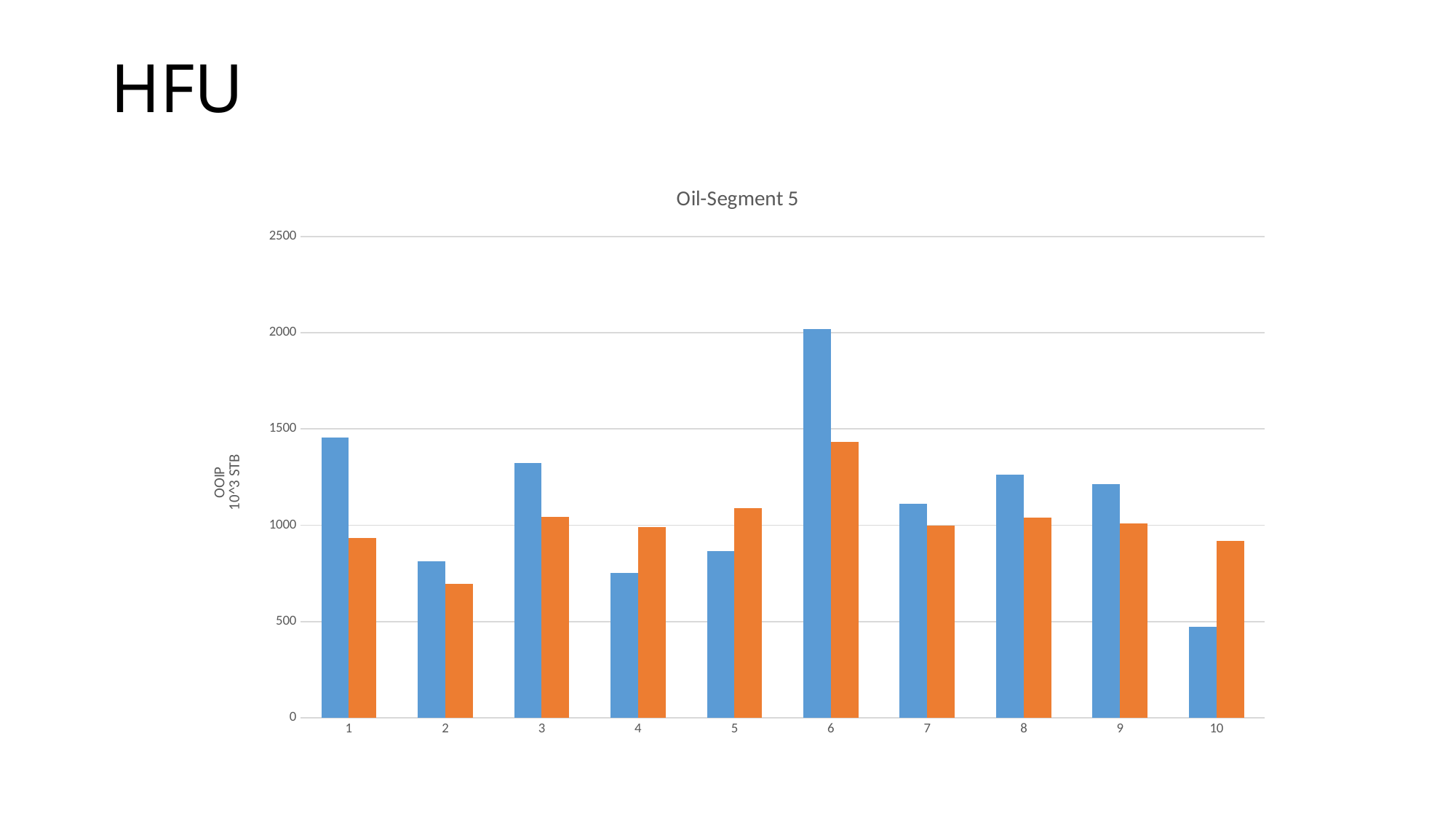
For the orange series, which category has the lowest value? 2 How many categories are shown along the x axis? 10 What is the label on the vertical axis of the chart? OOIP 10^3 STB Is the blue bar for category 10 greater or less than 500? less Is the blue bar for category 6 greater or less than 1500? greater For the blue series, which category has the lowest value? 10 What is the title of the chart? Oil-Segment 5 How many data series (bars per category) does the chart plot? 2 For the blue series, which category has the highest value? 6 For the orange series, which category has the highest value? 6 What kind of chart is shown on the slide? bar chart At category 10, which bar is larger, the blue one or the orange one? orange